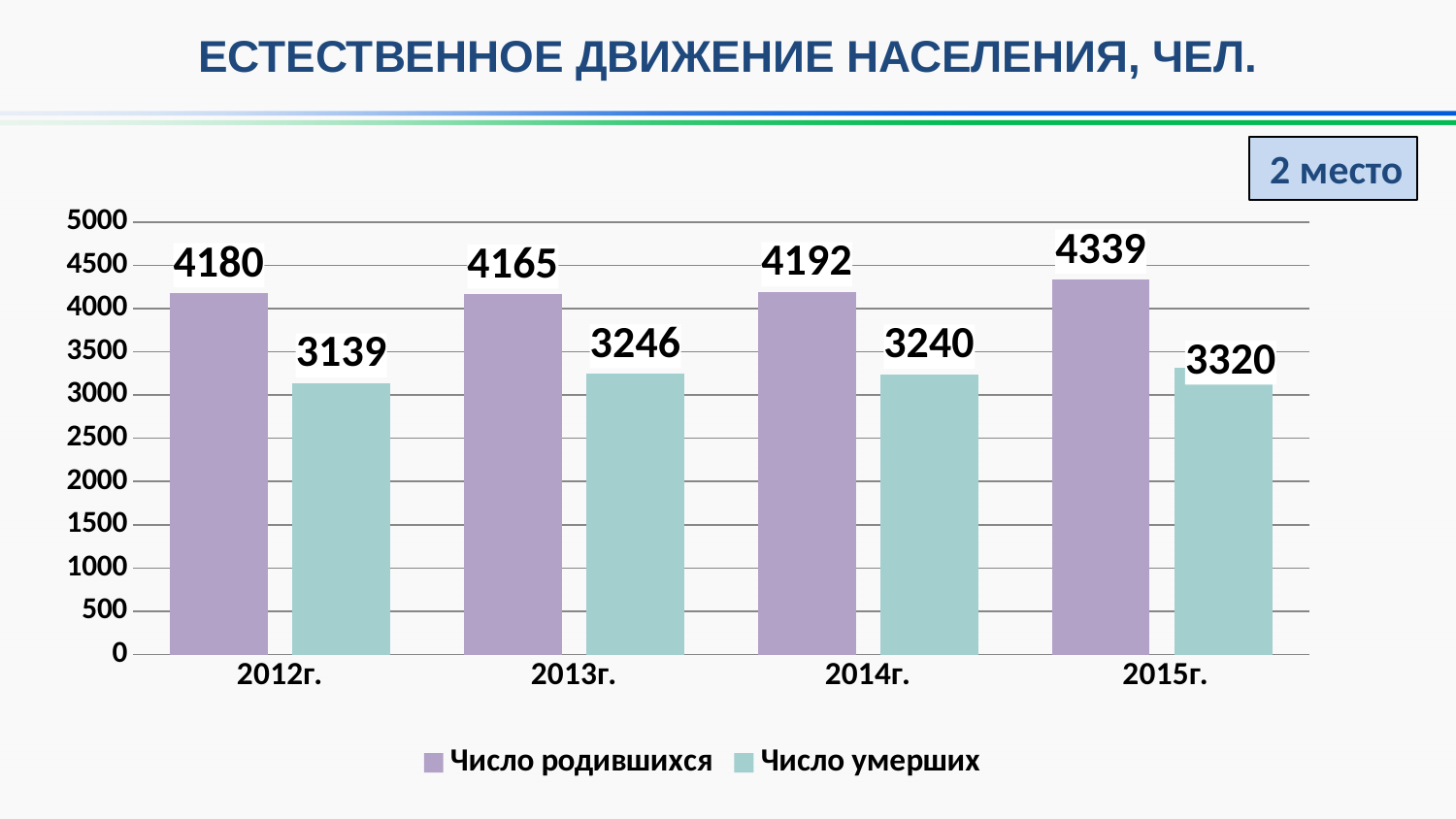
In which year is Число родившихся the highest? 2015г. In which year is Число умерших the lowest? 2012г. What is the value for Число умерших in 2013г.? 3246 What is the value for Число родившихся in 2015г.? 4339 What is the value for Число умерших in 2014г.? 3240 What is the difference between Число родившихся and Число умерших in 2012г.? 1041 How many years are shown on the x axis? 4 How many series does the legend list? 2 Which is larger in 2013г.: Число родившихся or Число умерших? Число родившихся What is the value for Число родившихся in 2012г.? 4180 What is the difference between Число родившихся in 2015г. and in 2014г.? 147 What kind of chart is shown on the slide? Bar chart